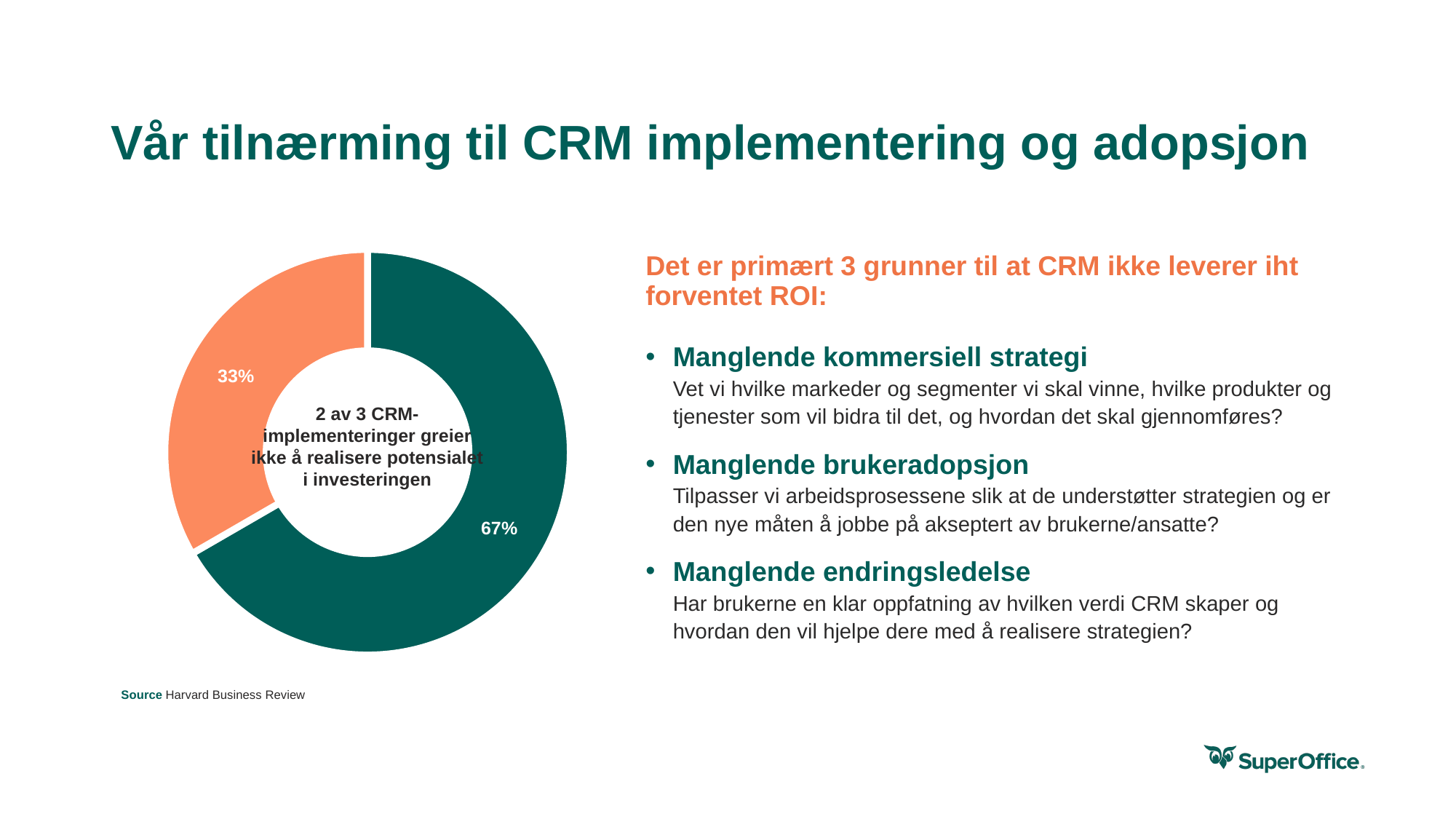
How many slices does the donut chart have? 2 Which slice of the donut chart is the smallest? The orange slice (33%) Is the orange slice of the donut chart larger or smaller than the dark green slice? Smaller What kind of chart is shown on the slide? Donut chart What text is written in the centre of the donut chart? 2 av 3 CRM-implementeringer greier ikke å realisere potensialet i investeringen What is the difference in percentage points between the two slices of the donut chart? 34 What percentage is shown on the orange slice of the donut chart? 33% Which slice of the donut chart is the largest? The dark green slice (67%) What source is cited for the donut chart? Harvard Business Review What is the total of the two percentages shown on the donut chart? 100% What percentage is shown on the dark green slice of the donut chart? 67%